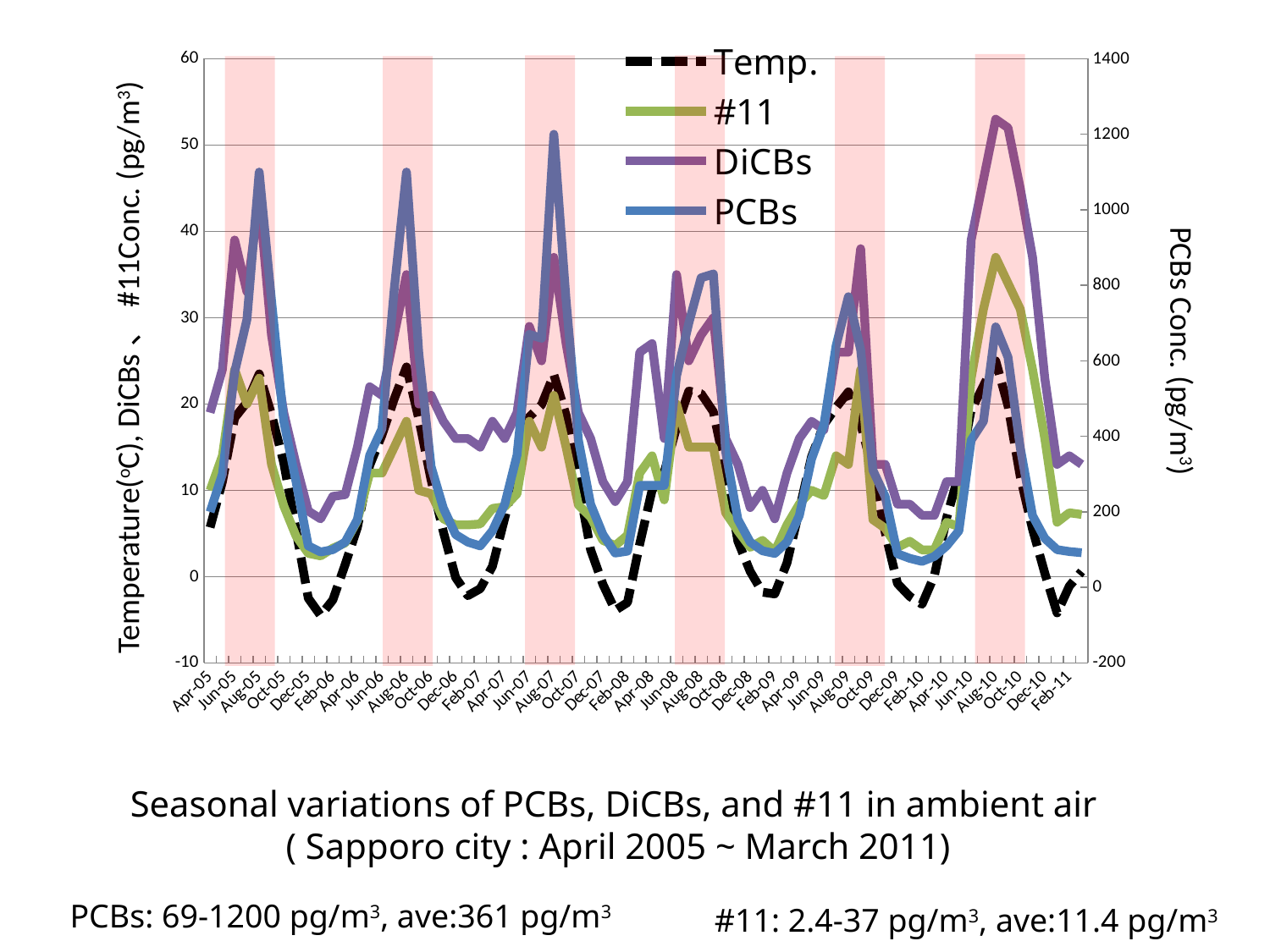
How many month labels are shown along the x axis? 36 Is the Temp. value at Feb-06 greater or less than 0? less Is the Temp. value at Aug-05 greater or less than 20? greater What kind of chart is shown on the slide? line chart Which series in the legend is drawn with a dashed line? Temp. In which month does the DiCBs series reach its highest peak? Aug-10 Which is larger, the DiCBs peak at Aug-10 or the DiCBs peak at Aug-05? Aug-10 How many series does the legend list? 4 Does the #11 series rise or fall from Jun-10 to Aug-10? rise Is the PCBs value at Aug-07 greater or less than 1000 on the right axis? greater What is the label of the right-hand vertical axis? PCBs Conc. (pg/m3)